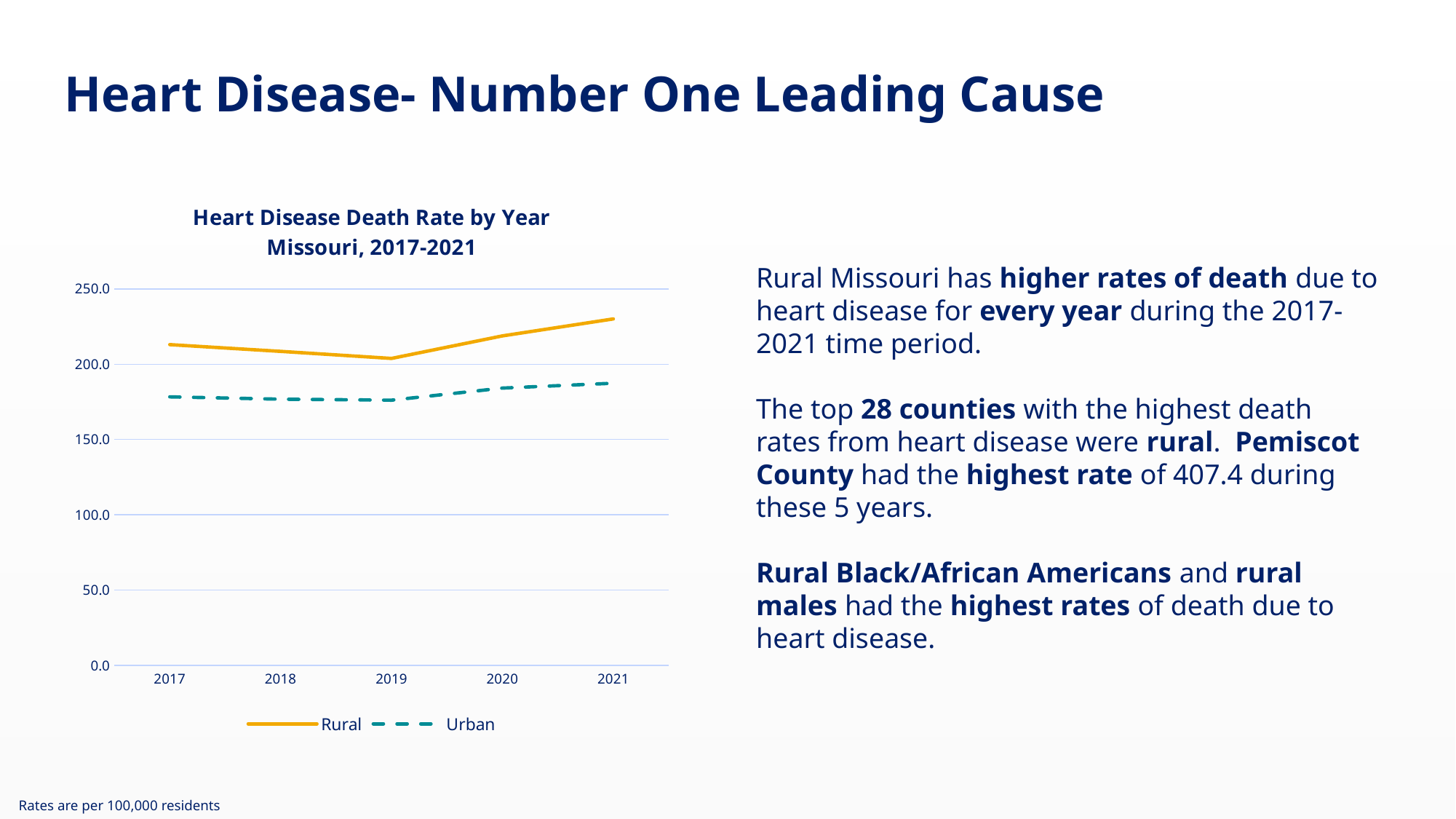
In which year is the Rural heart disease death rate highest? 2021 Does the Rural death rate rise or fall from 2019 to 2021? rise What is the title of the chart? Heart Disease Death Rate by Year Missouri, 2017-2021 Is the Urban value for 2019 greater or less than 150? greater Which series is drawn with a dashed line? Urban How many series does the chart's legend list? 2 Is the Rural value for 2021 greater or less than 200? greater In which year is the Rural heart disease death rate lowest? 2019 Which series has the higher heart disease death rate in 2019, Rural or Urban? Rural How many years are plotted along the x axis of the chart? 5 Is the Urban value for 2017 greater or less than 200? less What kind of chart is shown on the slide? line chart